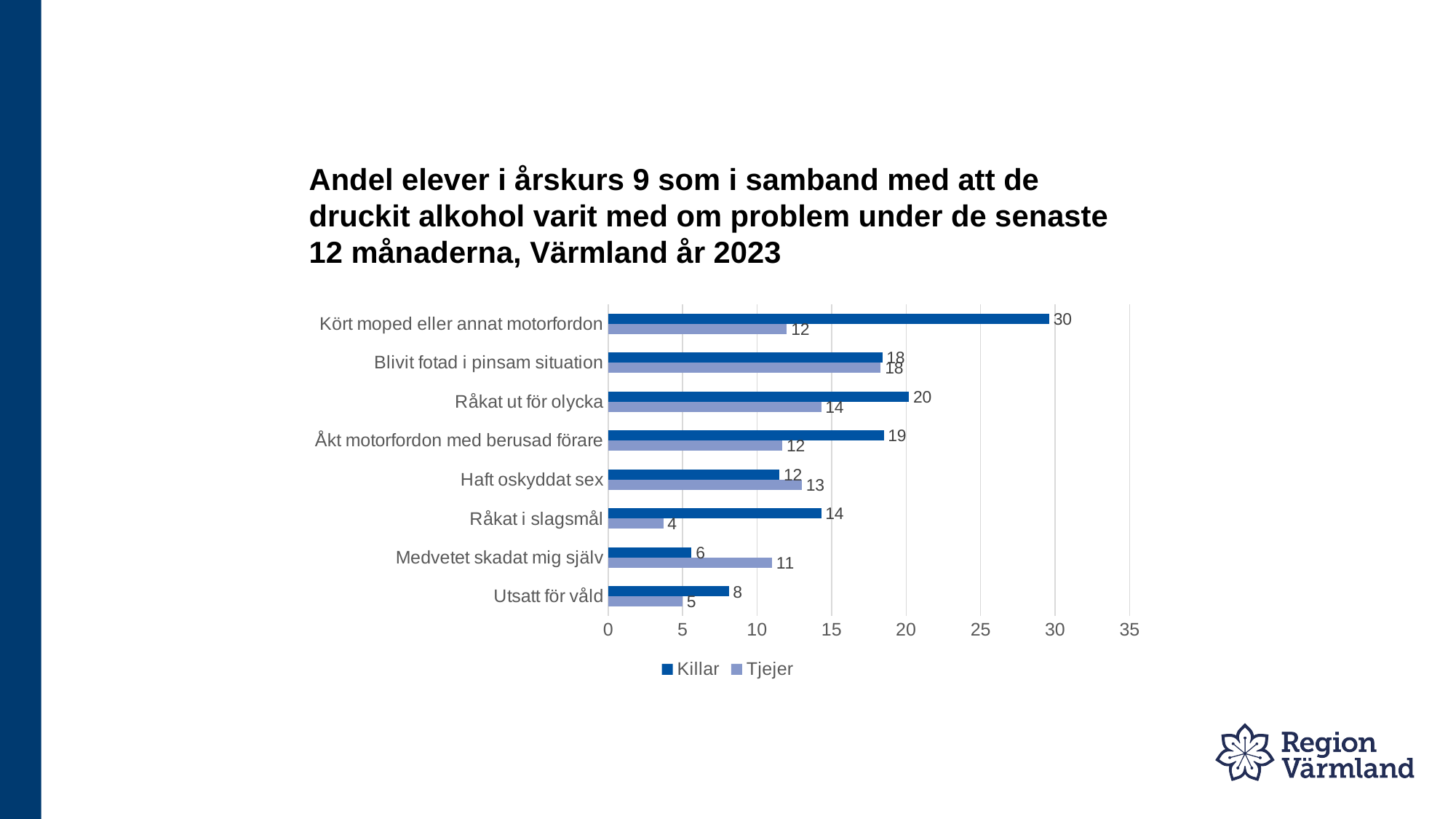
What is the value for Tjejer for 'Råkat i slagsmål'? 4 What is the value for Killar for 'Kört moped eller annat motorfordon'? 30 What kind of chart is shown on the slide? Bar chart What is the value for Tjejer for 'Medvetet skadat mig själv'? 11 Which category has the highest value for Killar? Kört moped eller annat motorfordon What is the difference between the Killar and Tjejer values for 'Kört moped eller annat motorfordon'? 18 How many categories are shown on the chart? 8 What are the two series named in the legend? Killar and Tjejer Is the Killar value for 'Råkat ut för olycka' greater or less than 15? greater How many series does the legend list? 2 Which is larger for 'Medvetet skadat mig själv', the Killar value or the Tjejer value? Tjejer Which category has the lowest value for Tjejer? Råkat i slagsmål